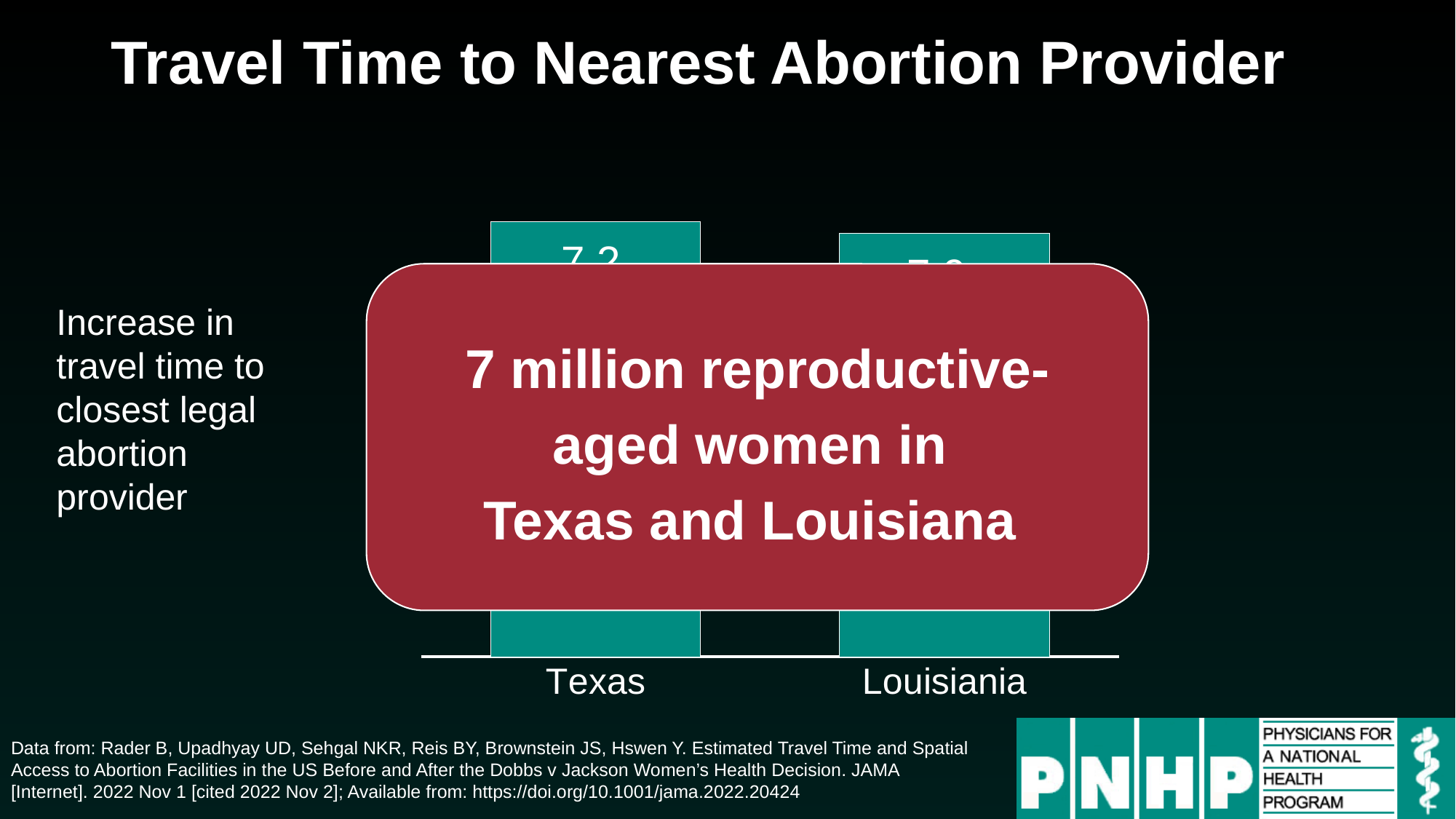
What kind of chart is shown on the slide? bar chart Which category has the lowest bar in the chart? Louisiania How many categories (bars) does the chart show? 2 What is the title of the slide containing the chart? Travel Time to Nearest Abortion Provider Which bar is taller, Texas or Louisiania? Texas Which category has the highest bar in the chart? Texas What are the two categories labelled on the x axis of the chart? Texas and Louisiania